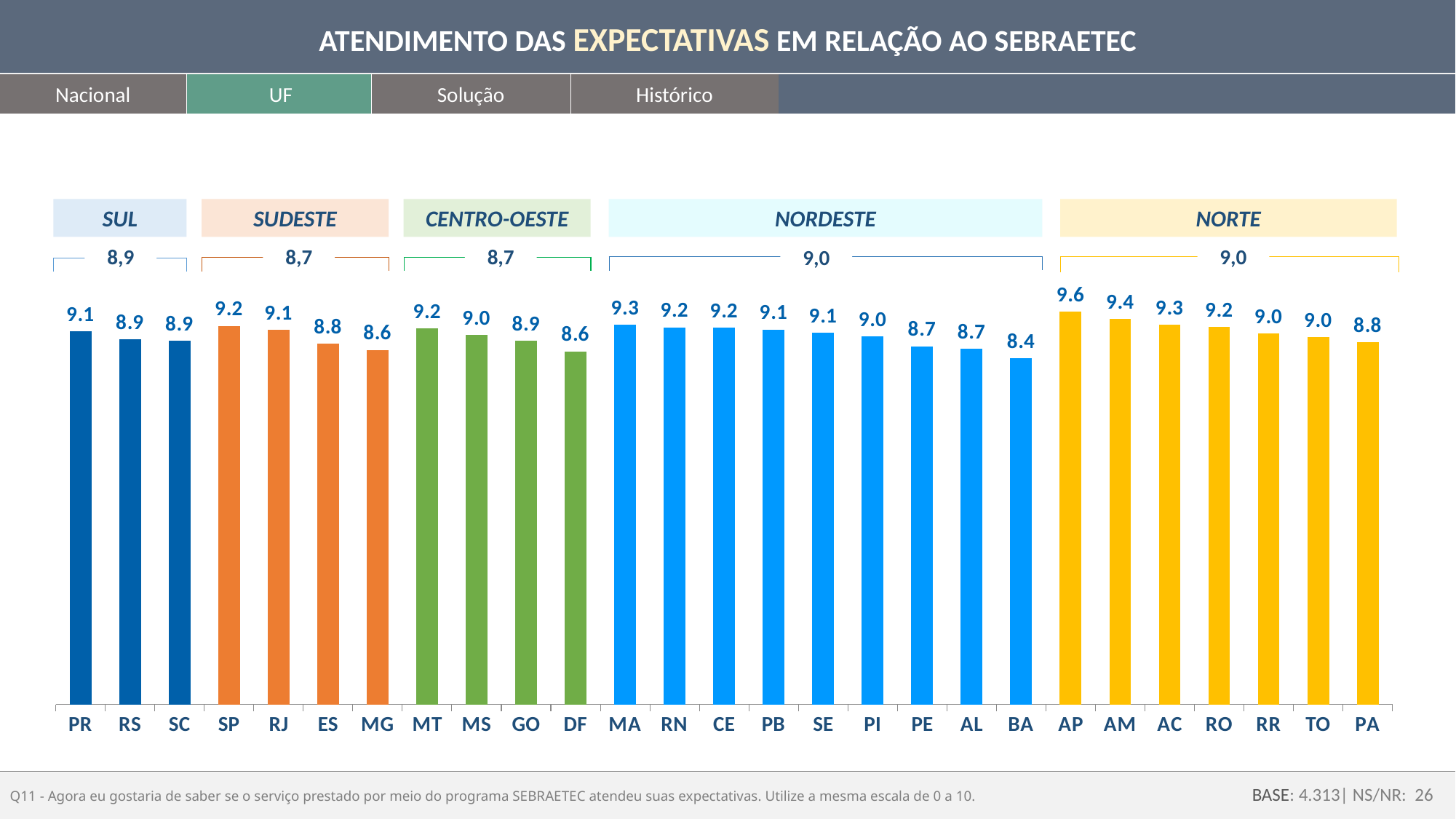
Which has a higher value, MA or PE? MA What kind of chart is shown on the slide? Bar chart What is the value shown for MG? 8.6 What is the value shown for BA? 8.4 What is the difference between the values for SP and MG? 0.6 Which state has the lowest value in the chart? BA What is the difference between the values for AP and BA? 1.2 How many states (bars) are shown in the chart? 27 Which state has the highest value in the chart? AP What is the value shown for AP? 9.6 How many states are shown in the NORDESTE group? 9 What is the regional value shown above the NORTE group? 9,0